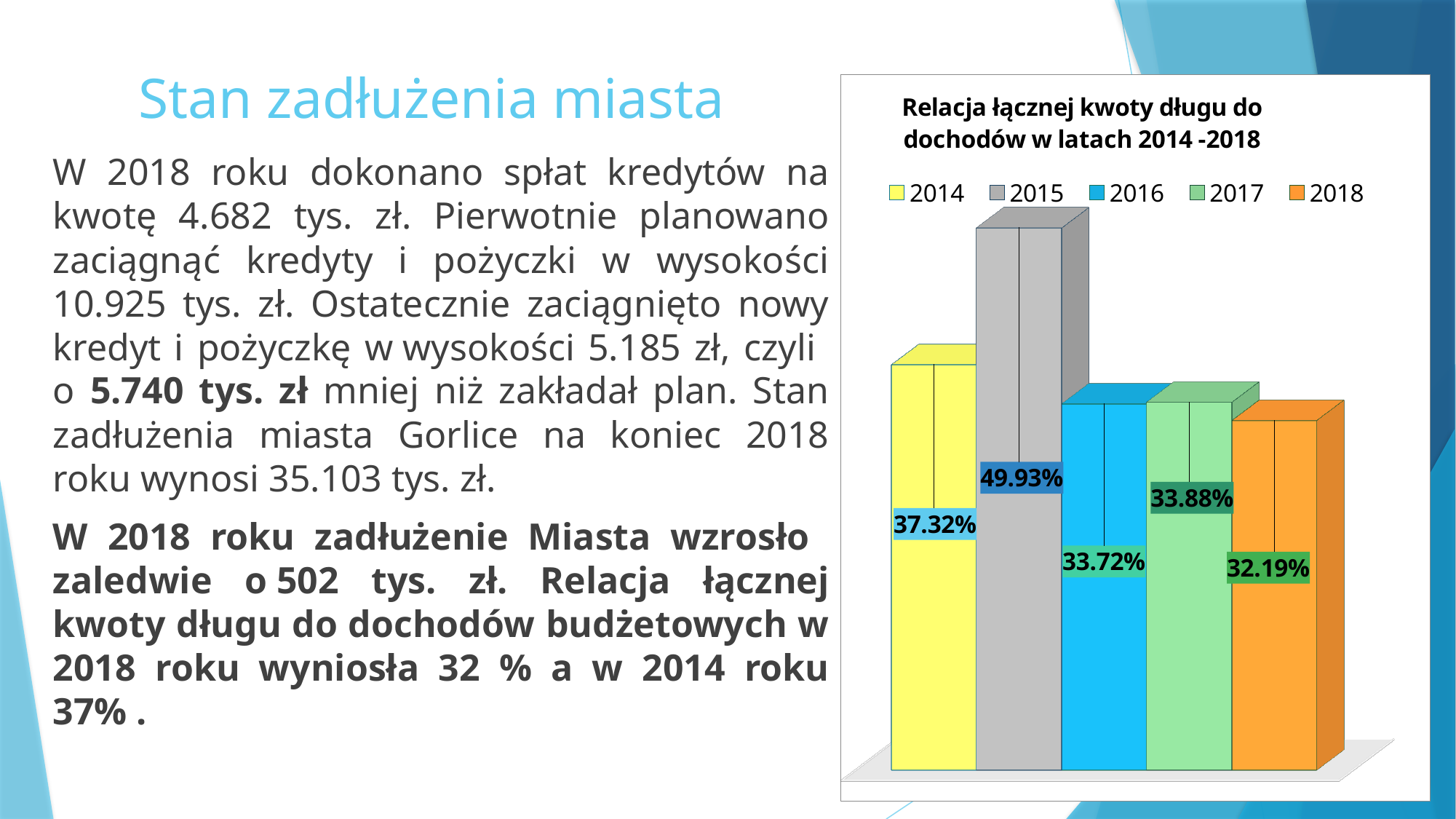
Which is larger, the value for 2014 or the value for 2018? 2014 What is the difference between the values for 2015 and 2014? 12.61 percentage points Which year has the lowest value in the chart? 2018 What is the value shown for 2016 in the chart? 33.72% What kind of chart is shown on the slide? Bar chart What is the value shown for 2015 in the chart? 49.93% Which year has the highest value in the chart? 2015 What is the difference between the values for 2014 and 2018? 5.13 percentage points What is the value shown for 2017 in the chart? 33.88% How many bars are plotted in the chart? 5 What is the value shown for 2014 in the chart? 37.32% What is the value shown for 2018 in the chart? 32.19%